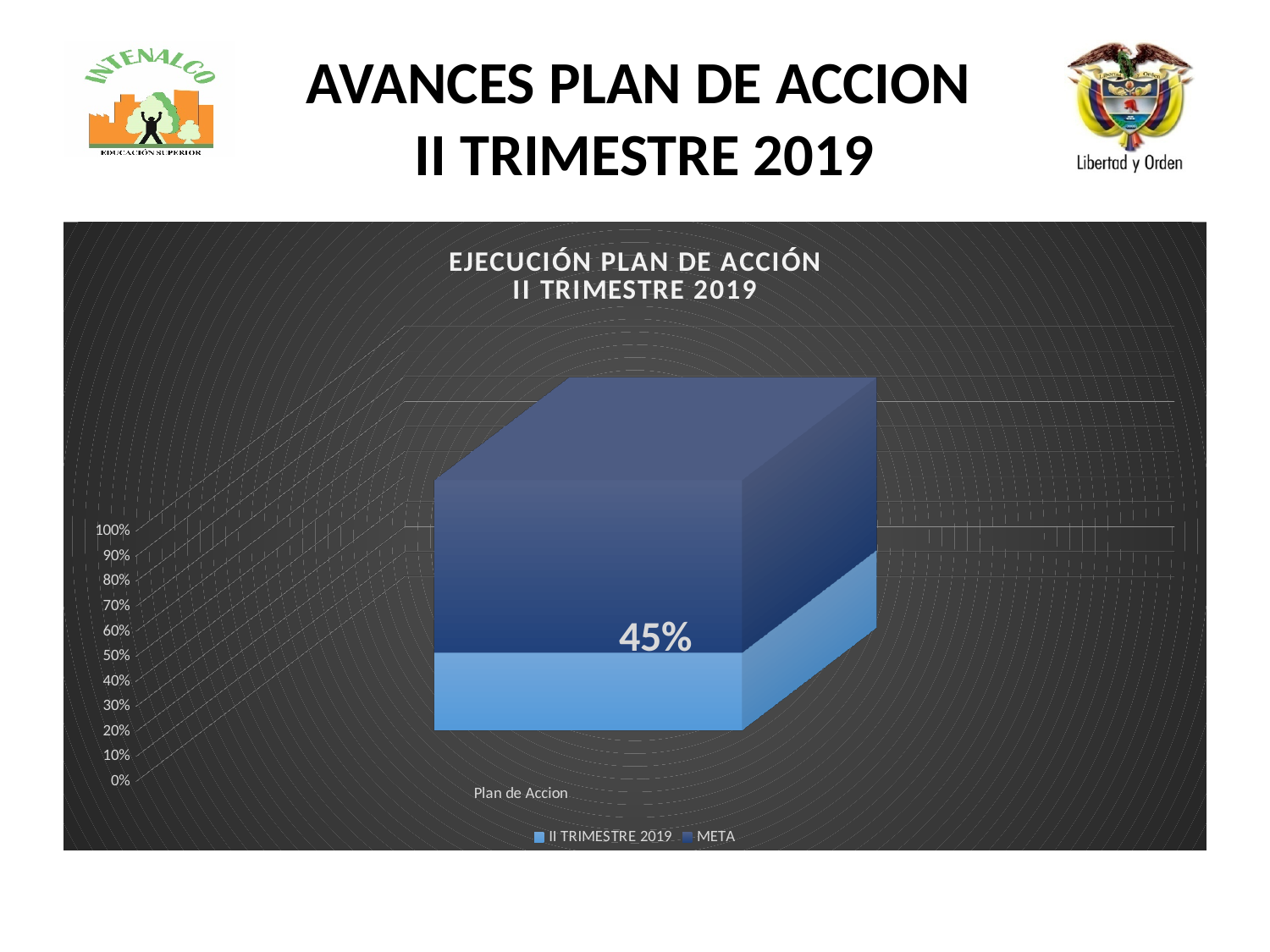
How many series does the chart legend list? 2 Which series has the larger segment in the bar, META or II TRIMESTRE 2019? META Is the value for II TRIMESTRE 2019 greater or less than 50%? less What is the value of the II TRIMESTRE 2019 series for Plan de Accion? 45% How many categories are plotted on the x axis of the chart? 1 What kind of chart is shown on the slide? bar chart What are the two series names listed in the chart legend? II TRIMESTRE 2019 and META What is the title of the chart? EJECUCIÓN PLAN DE ACCIÓN II TRIMESTRE 2019 Is the value for II TRIMESTRE 2019 greater or less than 40%? greater